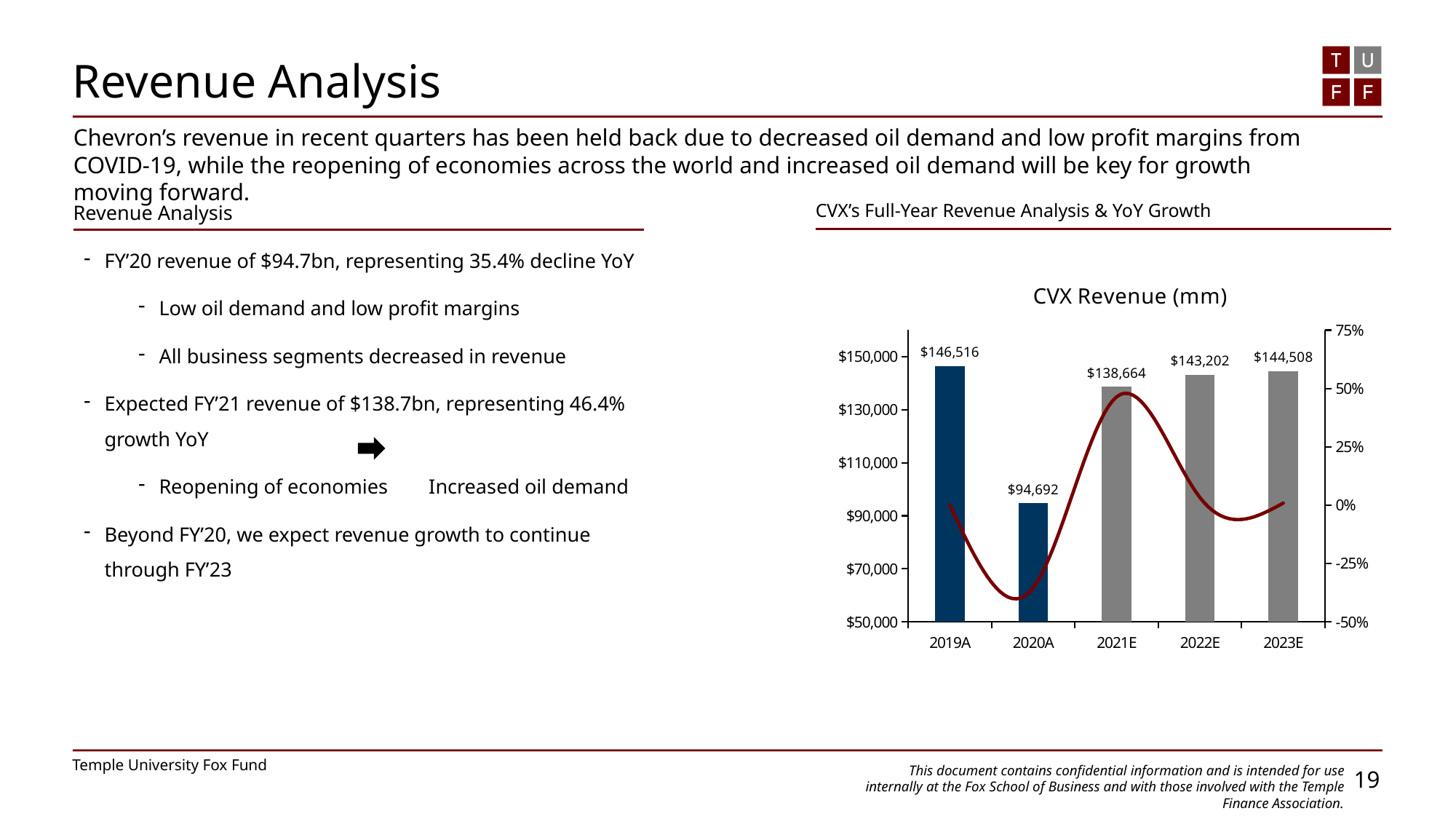
What is the revenue value shown for 2019A? $146,516 What type of chart is used to show CVX revenue? Bar chart with a line How many years are shown on the x axis of the chart? 5 What is the revenue value shown for 2021E? $138,664 What is the revenue value shown for 2020A? $94,692 What is the title of the chart on the slide? CVX Revenue (mm) Is the YoY growth line value for 2020A greater or less than -25%? less What is the revenue value shown for 2023E? $144,508 What is the difference between the 2019A and 2020A revenue values? $51,824 Which year has the lowest revenue bar? 2020A Which is larger, the revenue for 2022E or 2021E? 2022E Which year has the highest revenue bar? 2019A